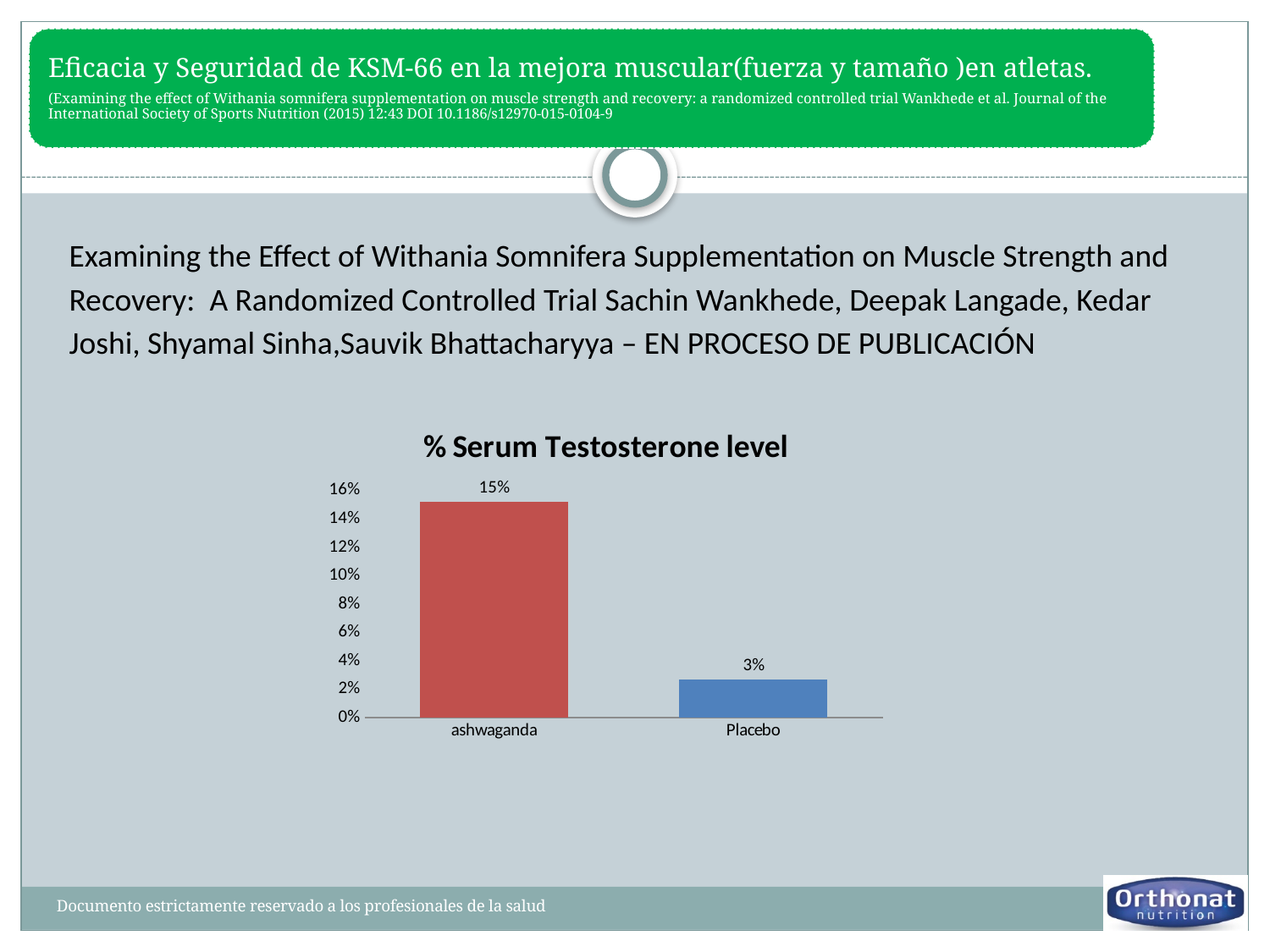
What kind of chart is shown on the slide? bar chart Which category has the highest value in the chart? ashwaganda Which category has the lowest value in the chart? Placebo What is the value for Placebo in the % Serum Testosterone level chart? 3% Is the value for Placebo greater or less than 4%? less How many categories are shown in the chart? 2 Is the value for ashwaganda greater or less than 10%? greater What colour is the bar for ashwaganda? red Which is larger, the value for ashwaganda or the value for Placebo? ashwaganda What is the title of the chart? % Serum Testosterone level What is the difference between the ashwaganda and Placebo values? 12% What is the value for ashwaganda in the % Serum Testosterone level chart? 15%